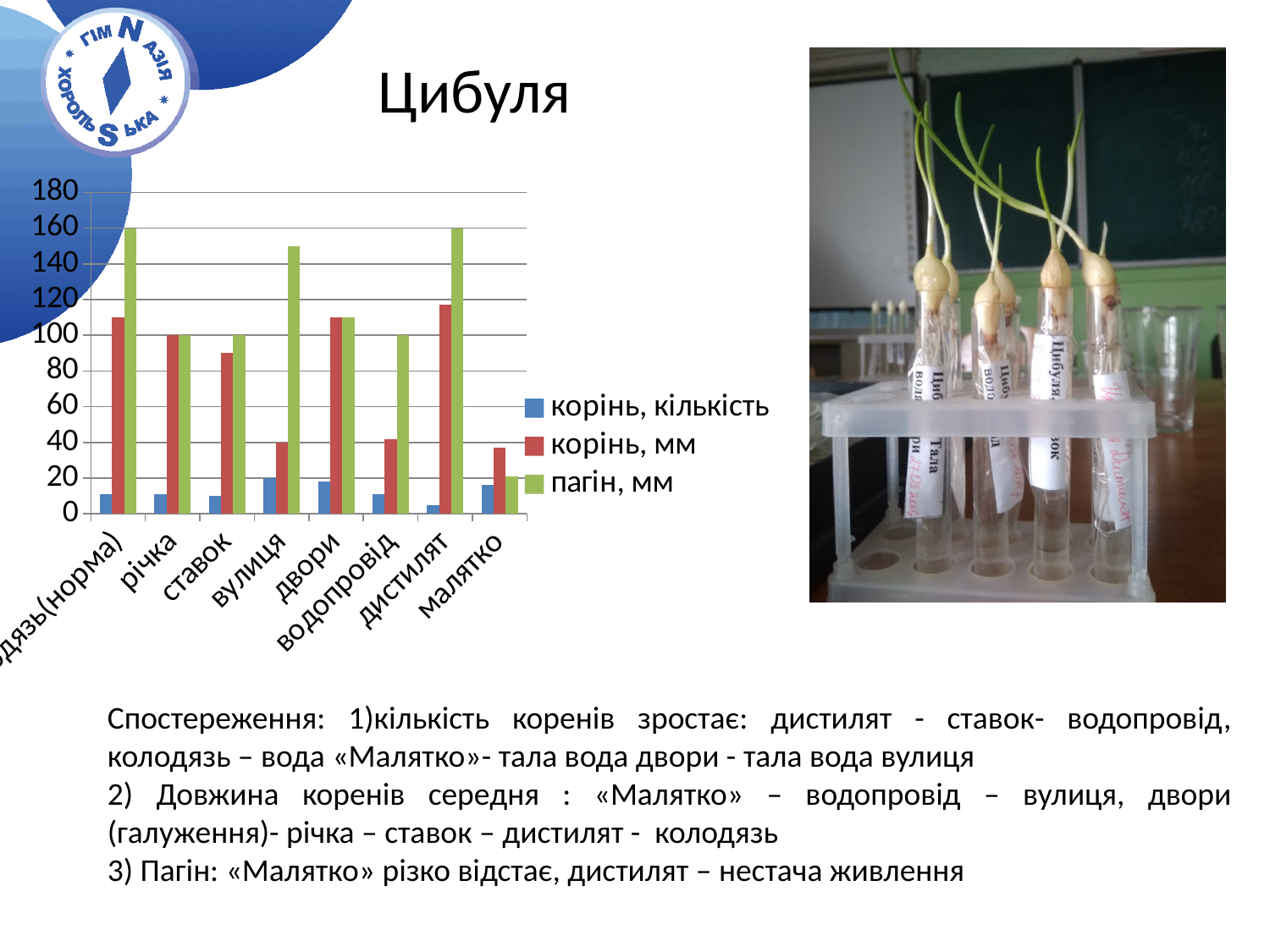
Is the value of корінь, мм for ставок greater or less than 100? less Which is larger: пагін, мм for річка or пагін, мм for вулиця? вулиця What kind of chart is shown on the slide? bar chart How many categories are shown on the x axis of the chart? 8 Is the value of пагін, мм for вулиця greater or less than 140? greater What is the title of the slide containing the chart? Цибуля Is the value of корінь, мм for дистилят greater or less than 100? greater Which series is shown in green in the chart? пагін, мм What is the value of пагін, мм for річка? 100 Which category has the lowest value for пагін, мм? малятко How many series does the chart legend list? 3 Which is larger: корінь, мм for ставок or корінь, мм for двори? двори